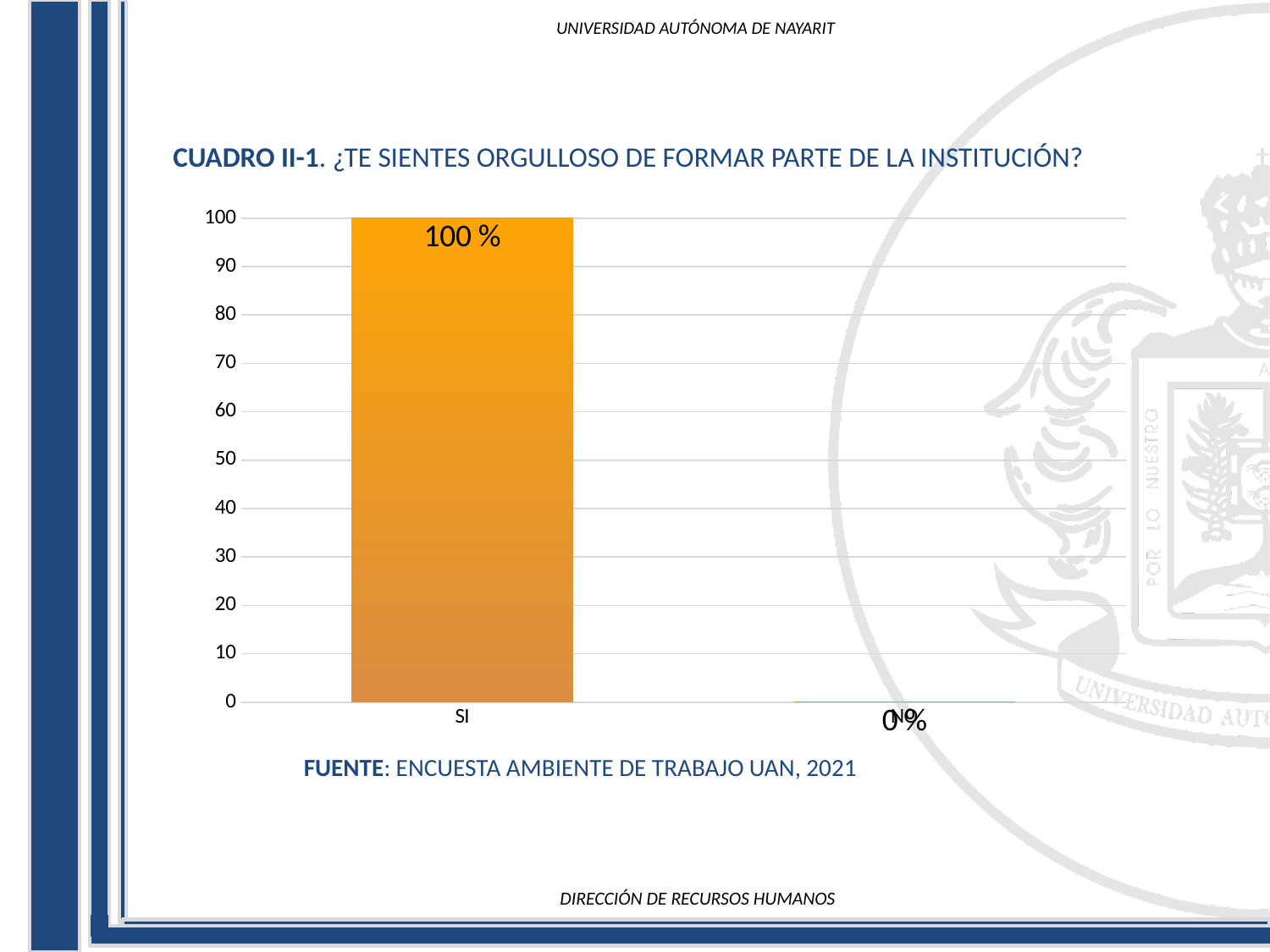
What is the title of the chart? CUADRO II-1. ¿TE SIENTES ORGULLOSO DE FORMAR PARTE DE LA INSTITUCIÓN? Is the value for SI greater or less than 50? greater Which category has the highest value? SI What value is shown for the SI bar? 100 % How many categories are shown on the x axis? 2 Which category has the lowest value? NO What is the difference between the SI and NO values? 100 What is the maximum value shown on the y axis? 100 What is the source cited below the chart? ENCUESTA AMBIENTE DE TRABAJO UAN, 2021 What value is shown for the NO category? 0% Which is larger, the value for SI or the value for NO? SI What kind of chart is shown on the slide? bar chart